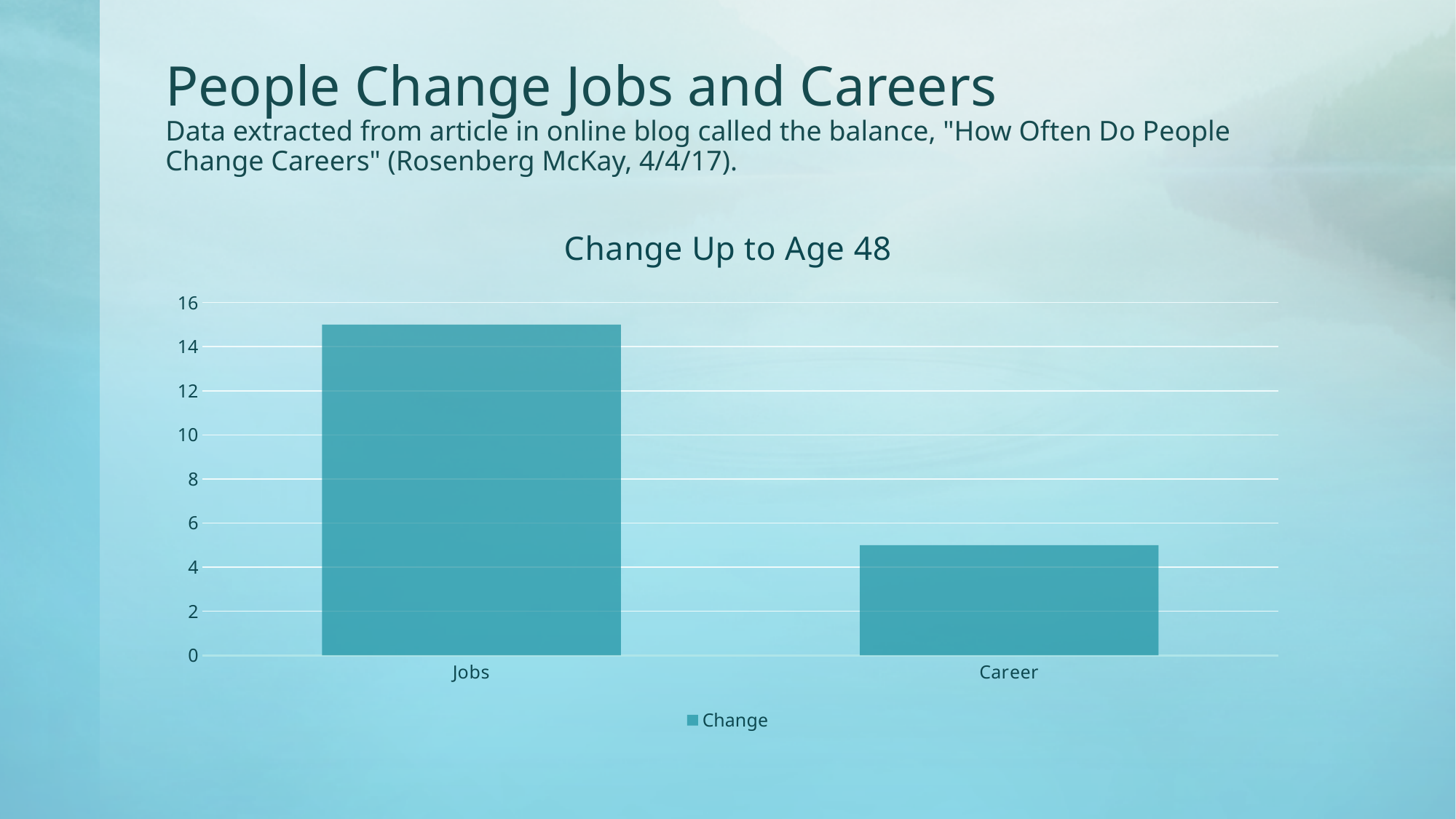
Is the value for Career greater or less than 4? greater Which category has the lowest bar in the chart? Career What type of chart is shown on the slide? bar chart Which is larger, the value for Jobs or the value for Career? Jobs What is the title of the chart? Change Up to Age 48 What series name is shown in the chart legend? Change How many series does the chart legend list? 1 Is the value for Jobs greater or less than 16? less Which category has the highest bar in the chart? Jobs How many categories are shown on the x axis of the chart? 2 Is the value for Career greater or less than 6? less